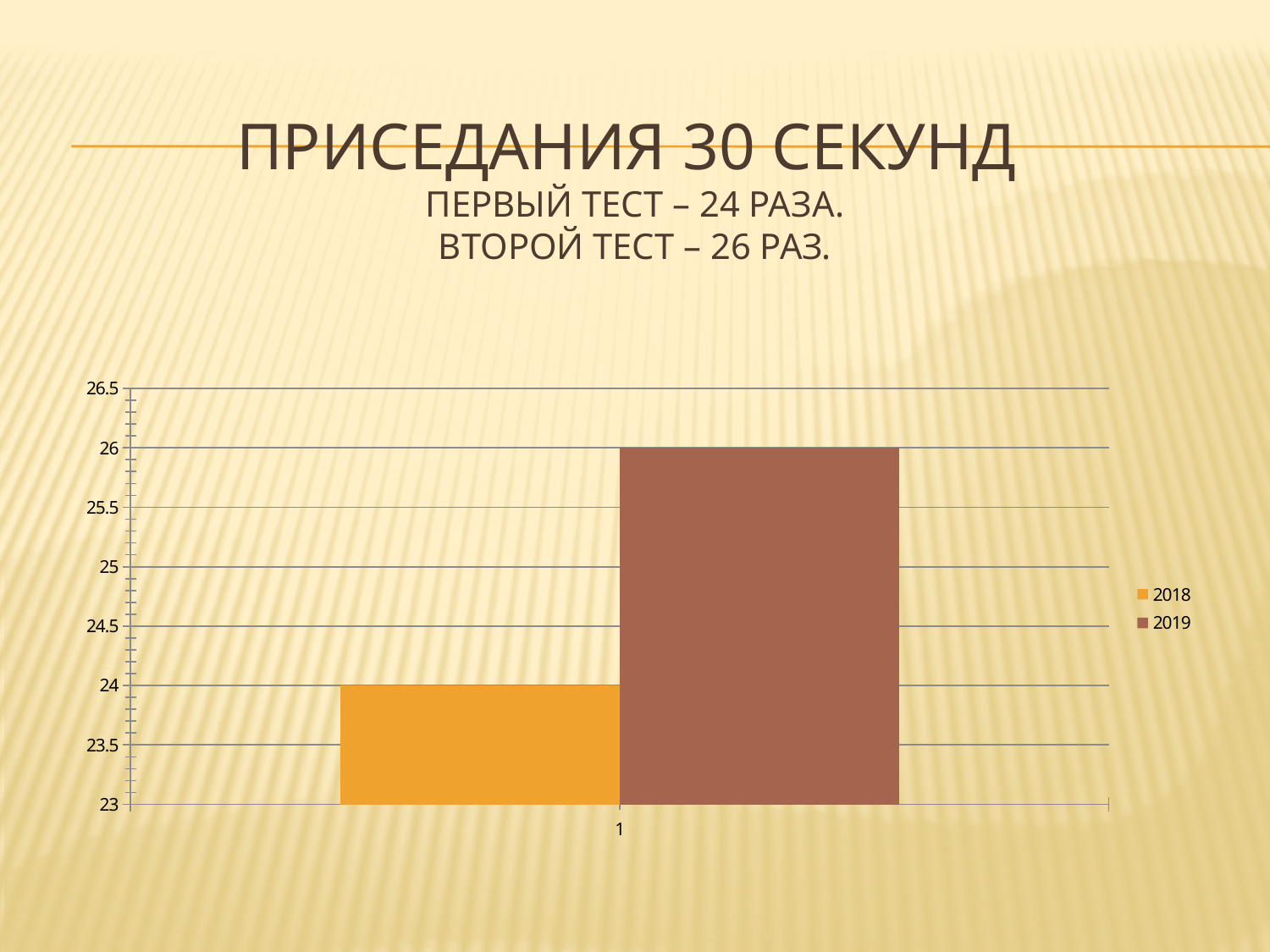
Which series has the highest value? 2019 How many series does the legend list? 2 Which series has the lowest value? 2018 Which series has the higher bar, 2018 or 2019? 2019 How many categories are shown on the x axis? 1 Is the value for 2019 greater or less than 25? greater What is the value of the 2019 bar? 26 What kind of chart is shown on the slide? bar chart What is the difference between the 2019 value and the 2018 value? 2 Is the value for 2018 greater or less than 25? less What is the value of the 2018 bar? 24 What are the series names listed in the legend? 2018 and 2019